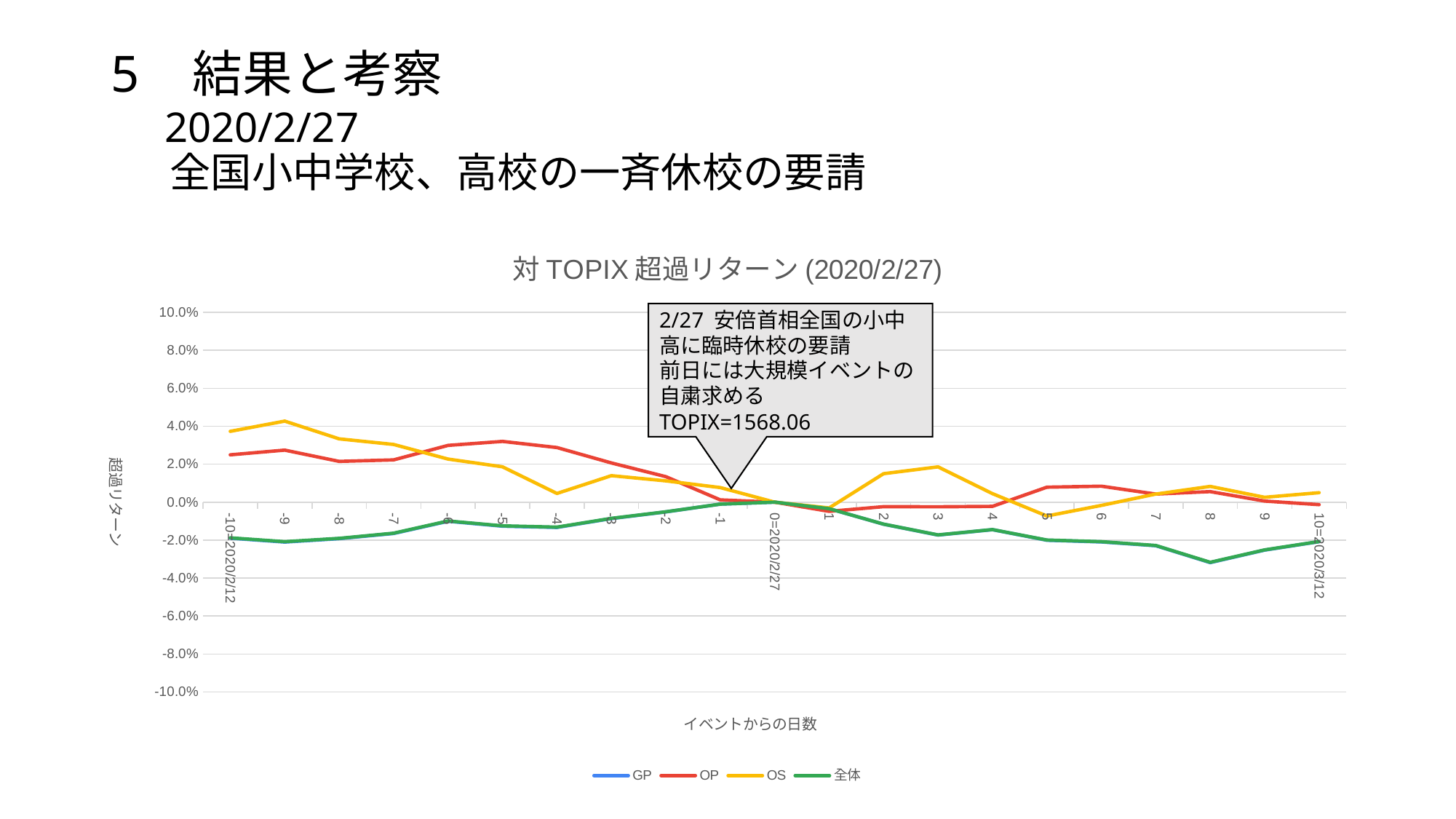
At day 8, which series has the larger value, OP or 全体? OP How many series does the legend list? 4 Which series has the highest value at day -9? OS What kind of chart is shown on the slide? line chart What is the title of the chart? 対 TOPIX 超過リターン (2020/2/27) At day 3, which series has the larger value, OS or OP? OS Is the value for 全体 at day 8 greater or less than -2.0%? less Is the value for OS at day -10 greater or less than 2.0%? greater How many points (days) are shown along the x axis? 21 Is the value for OP at day -5 greater or less than 2.0%? greater What is the label of the x axis? イベントからの日数 Does the 全体 line rise or fall from day -10 to day 0? rise